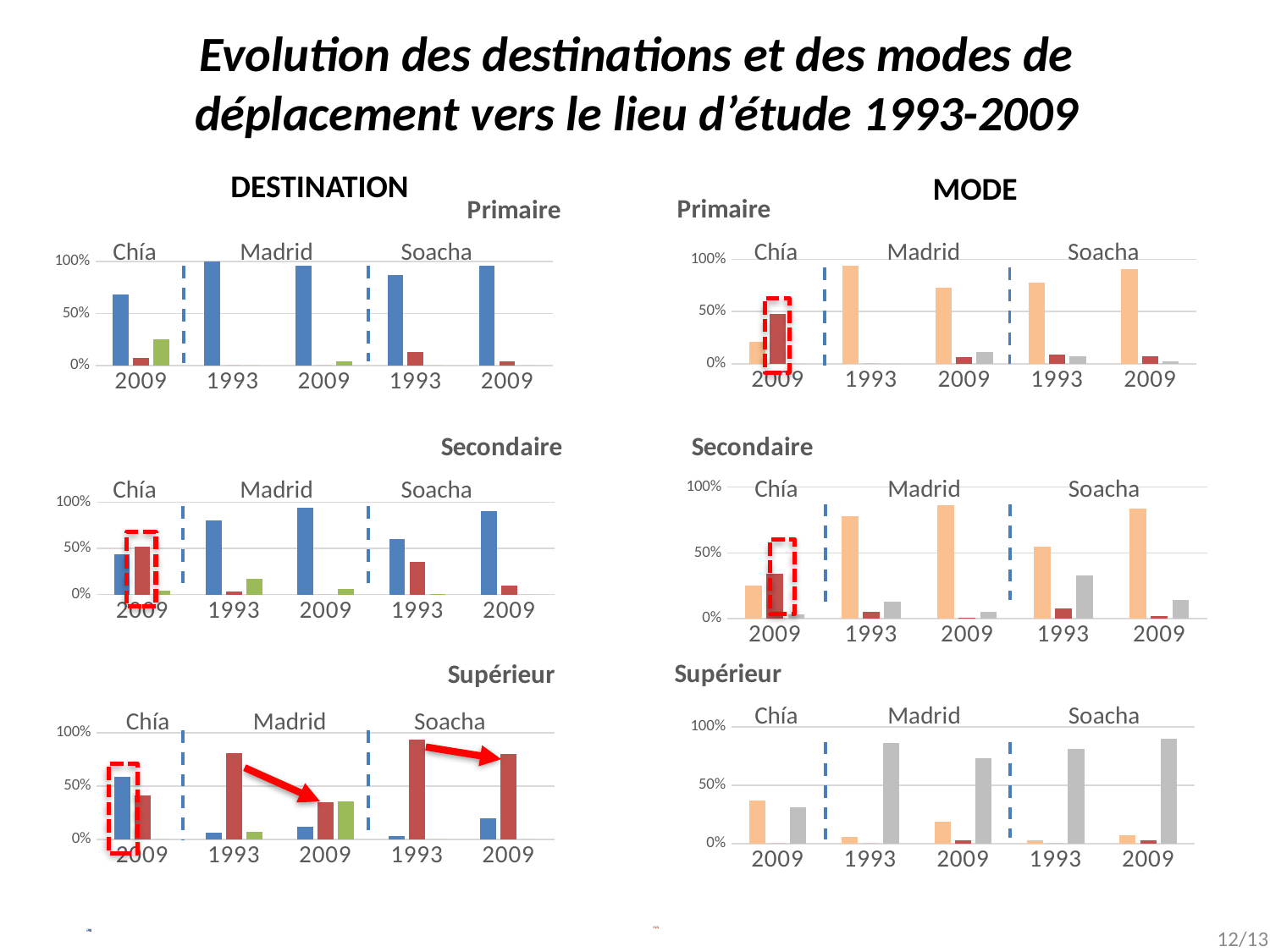
In the MODE Supérieur chart, is the orange bar for Chía 2009 greater or less than 50%? less In the MODE Secondaire chart, which grey bar for Soacha is taller, 1993 or 2009? 1993 In the DESTINATION Supérieur chart, does the red bar for Soacha rise or fall from 1993 to 2009? fall How many year labels are shown along the x axis of the MODE Primaire chart? 5 In the DESTINATION Primaire chart, for Chía 2009, which bar is taller, the green one or the red one? green In the DESTINATION Primaire chart, is the blue bar for Chía 2009 greater or less than 50%? greater In the DESTINATION Supérieur chart, which red bar for Madrid is taller, 1993 or 2009? 1993 In the MODE Supérieur chart, is the grey bar for Madrid 1993 greater or less than 50%? greater Which three cities are labelled across the top of each chart? Chía, Madrid, Soacha What kind of chart is the DESTINATION Primaire chart? bar chart